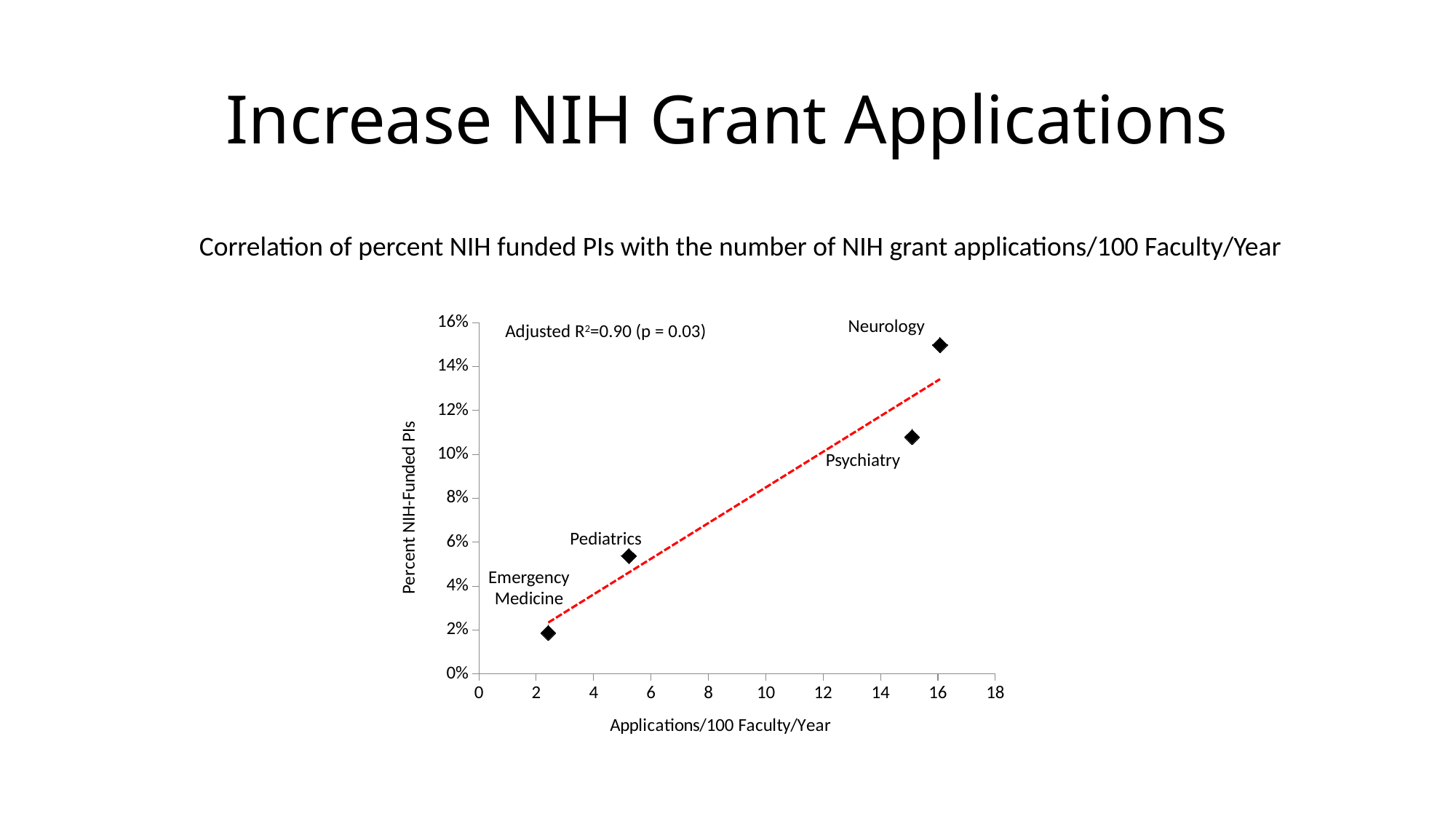
Which department has the lowest percent of NIH-funded PIs? Emergency Medicine How many departments are plotted as points on the chart? 4 Which has a higher percent of NIH-funded PIs, Pediatrics or Psychiatry? Psychiatry As applications per 100 faculty per year increase along the x axis, does the percent of NIH-funded PIs rise or fall? Rise What adjusted R² value is printed on the chart? 0.90 Is the number of applications per 100 faculty per year for Emergency Medicine greater or less than 4? less Is the percent of NIH-funded PIs for Pediatrics greater or less than 4%? greater Which department has the highest percent of NIH-funded PIs? Neurology Is the percent of NIH-funded PIs for Neurology greater or less than 14%? greater Which department has the fewest applications per 100 faculty per year? Emergency Medicine What kind of chart is shown on the slide? Scatter plot